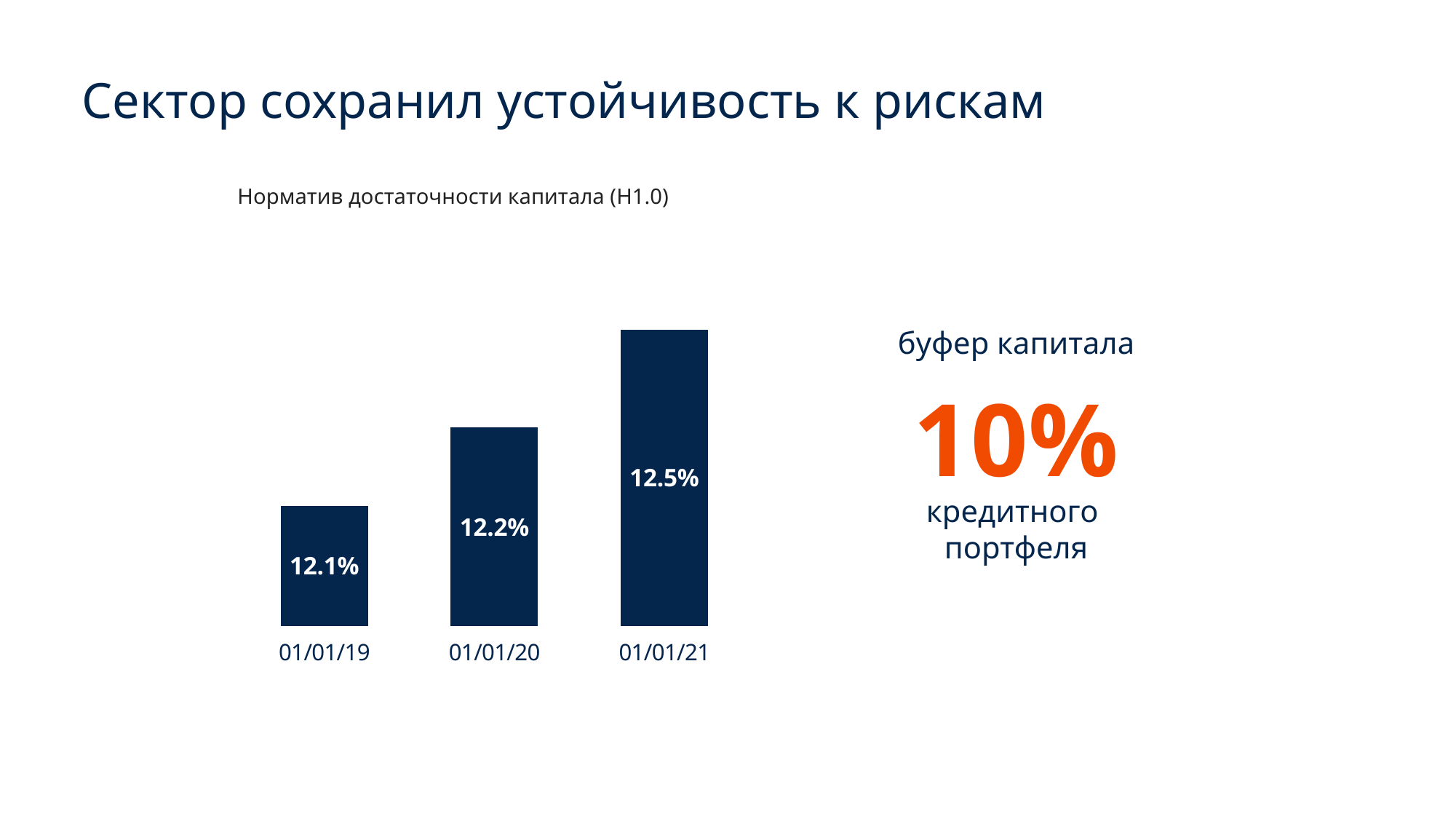
What is the difference between the values for 01/01/21 and 01/01/20? 0.3% Which date has the highest value? 01/01/21 Do the values rise or fall from 01/01/19 to 01/01/21? rise Which is larger, the value for 01/01/20 or the value for 01/01/21? 01/01/21 What is the title of the chart? Норматив достаточности капитала (Н1.0) What kind of chart is shown on the slide? bar chart Which date has the lowest value? 01/01/19 What is the difference between the values for 01/01/21 and 01/01/19? 0.4% What is the value for 01/01/21? 12.5% How many bars are shown in the chart? 3 What is the value for 01/01/19? 12.1% What is the value for 01/01/20? 12.2%